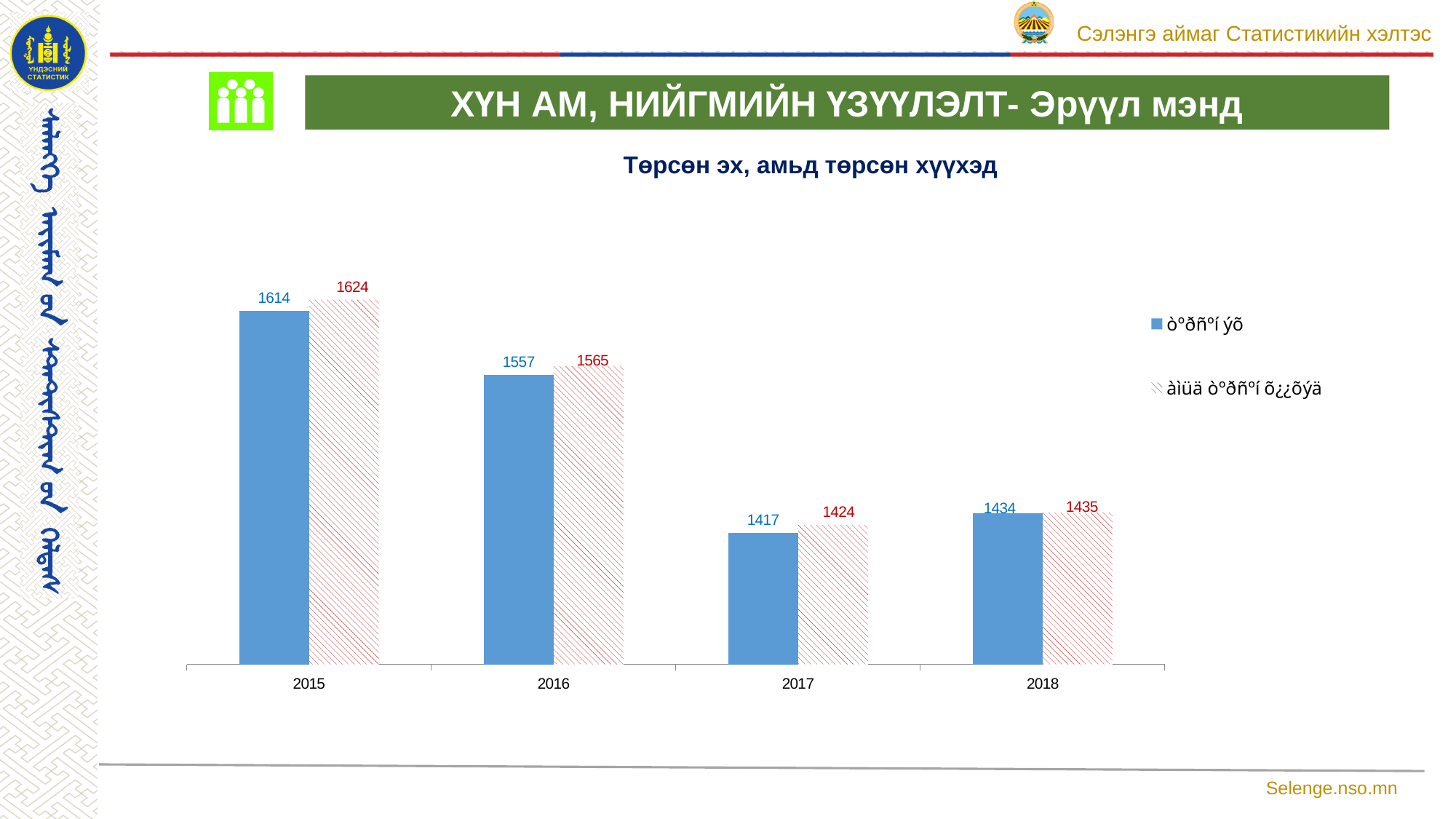
Which year has the larger blue solid bar value, 2017 or 2018? 2018 What is the value of the blue solid bar for 2018? 1434 By how much did the blue solid bar value decrease from 2015 to 2016? 57 What is the difference between the red hatched bar and the blue solid bar in 2015? 10 What is the value of the red hatched bar for 2017? 1424 How many years are shown on the x axis of the chart? 4 How many series does the chart's legend list? 2 What is the value of the blue solid bar for 2015? 1614 In which year is the blue solid bar lowest? 2017 In which year is the blue solid bar highest? 2015 What type of chart is shown on the slide? Bar chart What is the value of the red hatched bar for 2016? 1565